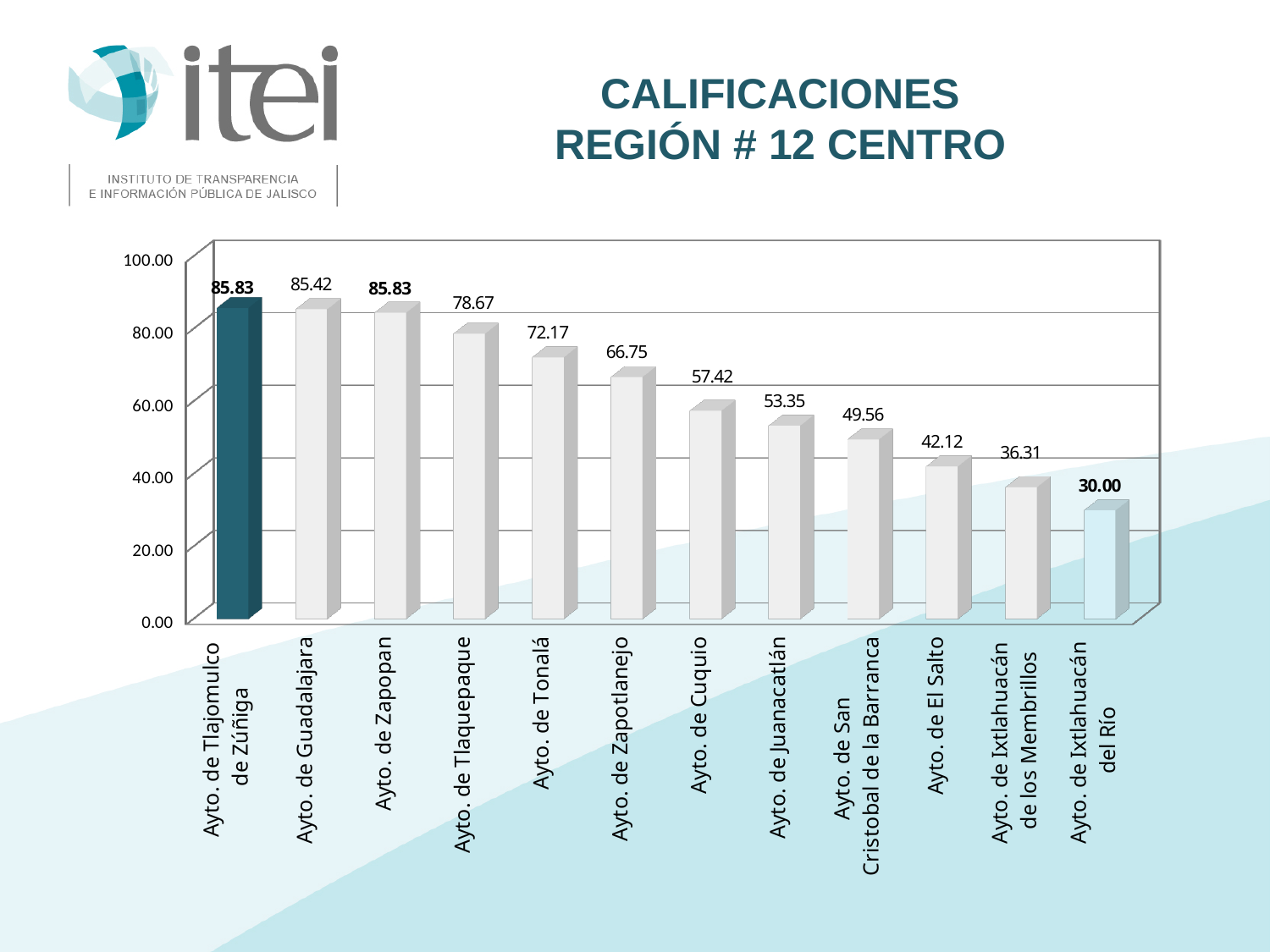
What is the value for Ayto. de Tlaquepaque? 78.67 What is the value for Ayto. de Cuquio? 57.42 What is the value for Ayto. de San Cristobal de la Barranca? 49.56 What kind of chart is shown on the slide? bar chart Do the values rise or fall from left to right along the x axis? fall What is the difference between the values for Ayto. de El Salto and Ayto. de Ixtlahuacán de los Membrillos? 5.81 What is the value for Ayto. de Guadalajara? 85.42 What is the difference between the values for Ayto. de Tlaquepaque and Ayto. de Tonalá? 6.50 Which category has the lowest value? Ayto. de Ixtlahuacán del Río Which is larger, the value for Ayto. de Cuquio or Ayto. de Juanacatlán? Ayto. de Cuquio How many categories are shown on the chart? 12 Is the value for Ayto. de Zapotlanejo greater or less than 60.00? greater